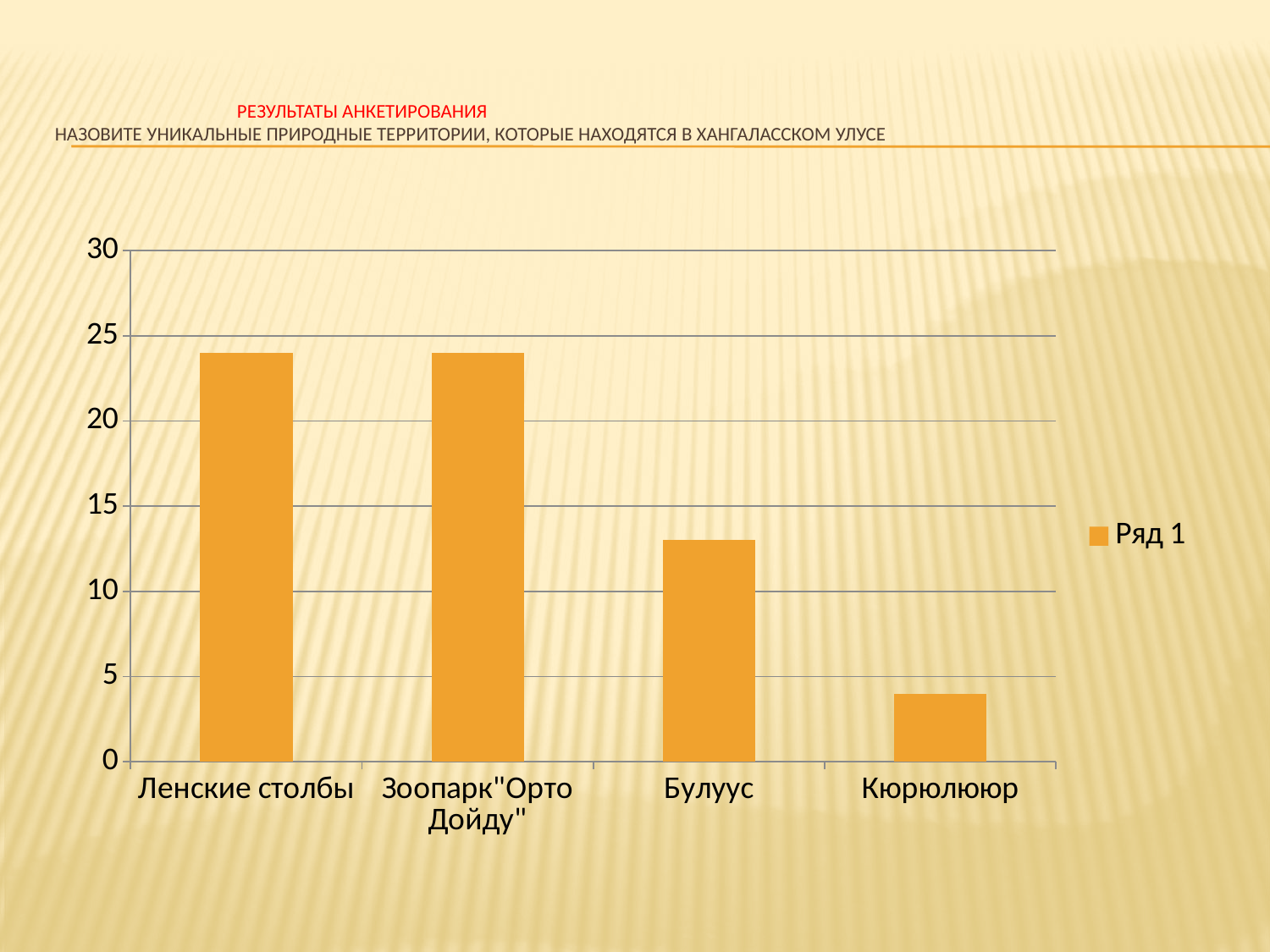
Is the value for Булуус greater or less than 10? greater Is the value for Зоопарк"Орто Дойду" greater or less than 25? less Which is larger, the value for Ленские столбы or the value for Булуус? Ленские столбы Which is larger, the value for Булуус or the value for Кюрюлююр? Булуус How many categories are shown on the x axis of the chart? 4 Which category has the lowest value in the chart? Кюрюлююр What is the name of the series shown in the chart legend? Ряд 1 What kind of chart is shown on the slide? bar chart How many series does the chart legend list? 1 Is the value for Кюрюлююр greater or less than 5? less Do the bar values generally rise or fall from left to right along the x axis? fall